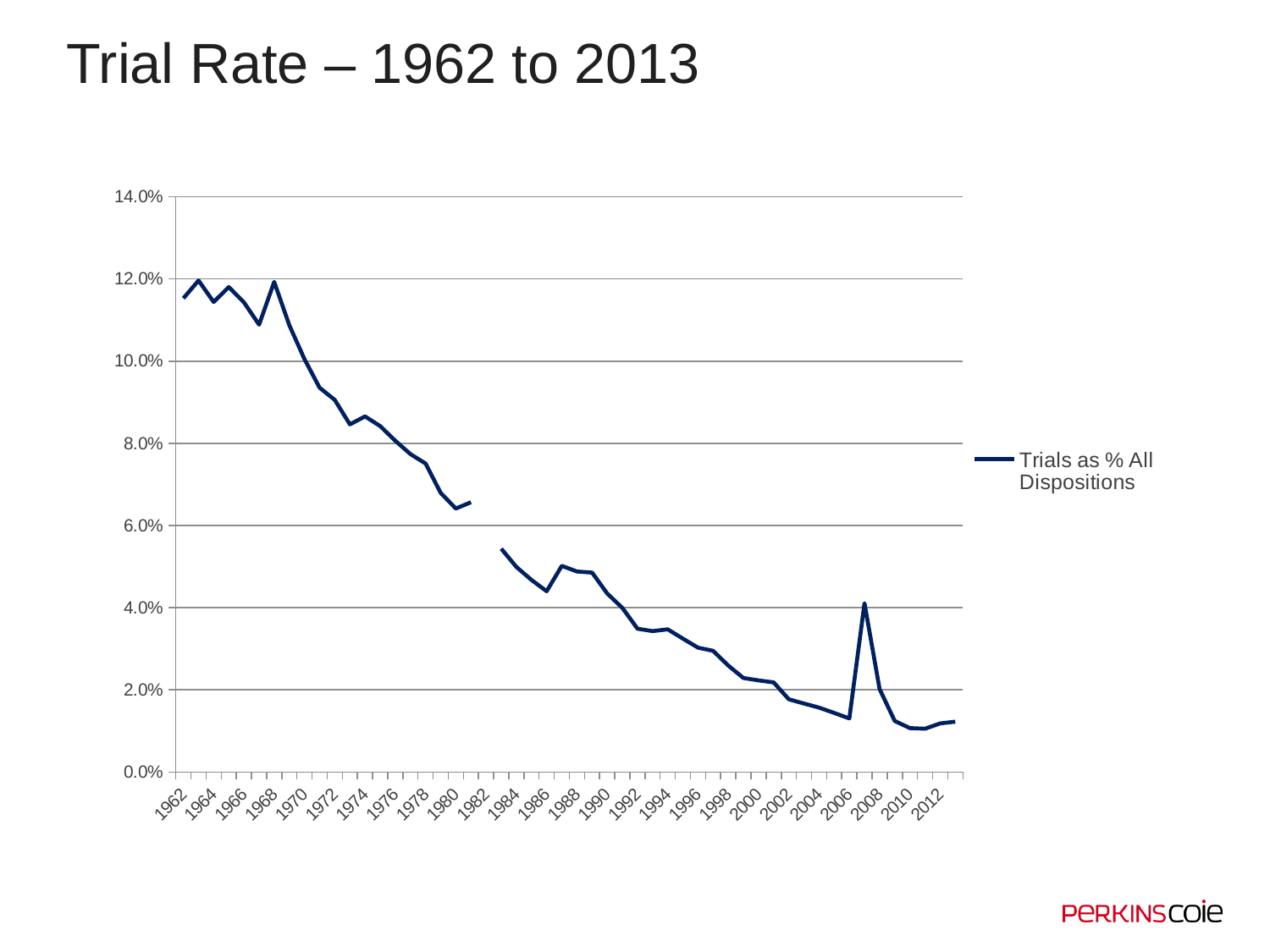
Is the value for 1962 greater or less than 10.0%? greater What is the legend entry for the plotted series? Trials as % All Dispositions Is the value for 1986 greater or less than 6.0%? less What is the title of the slide's chart? Trial Rate – 1962 to 2013 Overall, do the values rise or fall from 1962 to 2013? fall Which year has the larger value, 2006 or 2007? 2007 Which year has the larger value, 1970 or 1990? 1970 How many series does the legend list? 1 What kind of chart is shown on the slide? line chart Is the value for 2010 greater or less than 2.0%? less